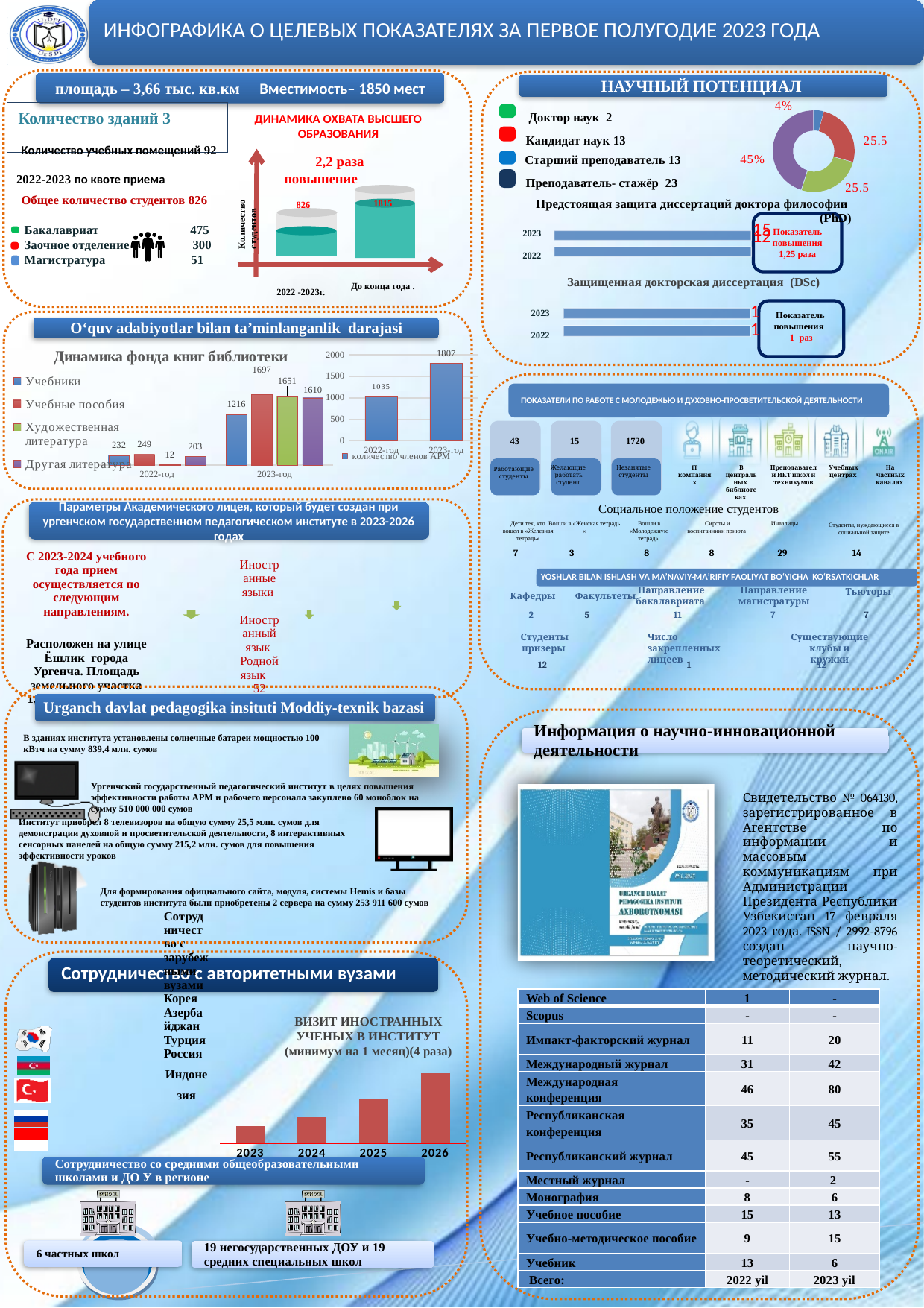
In the chart 'Предстоящая защита диссертаций доктора философии (PhD)', which year has the larger value, 2023 or 2022? 2023 How many years are shown on the x axis of the chart 'Визит иностранных ученых в институт'? 4 In the chart 'количество членов АРМ', what is the difference between the 2023-год and 2022-год values? 772 In the chart 'Динамика фонда книг библиотеки', what is the difference between the Учебники values for 2023-год and 2022-год? 984 In the chart 'Визит иностранных ученых в институт', do the values rise or fall from 2023 to 2026? rise In the chart 'Динамика фонда книг библиотеки', which series has the highest value in 2023-год? Учебные пособия In the chart 'Динамика фонда книг библиотеки', what is the value for Художественная литература in 2022-год? 12 In the chart 'Динамика фонда книг библиотеки', what is the value for Учебные пособия in 2023-год? 1697 What kind of chart is 'Динамика фонда книг библиотеки'? bar chart How many series does the legend of the chart 'Динамика фонда книг библиотеки' list? 4 In the chart 'Динамика фонда книг библиотеки', which series has the lowest value in 2022-год? Художественная литература In the chart 'количество членов АРМ', what is the value for 2023-год? 1807